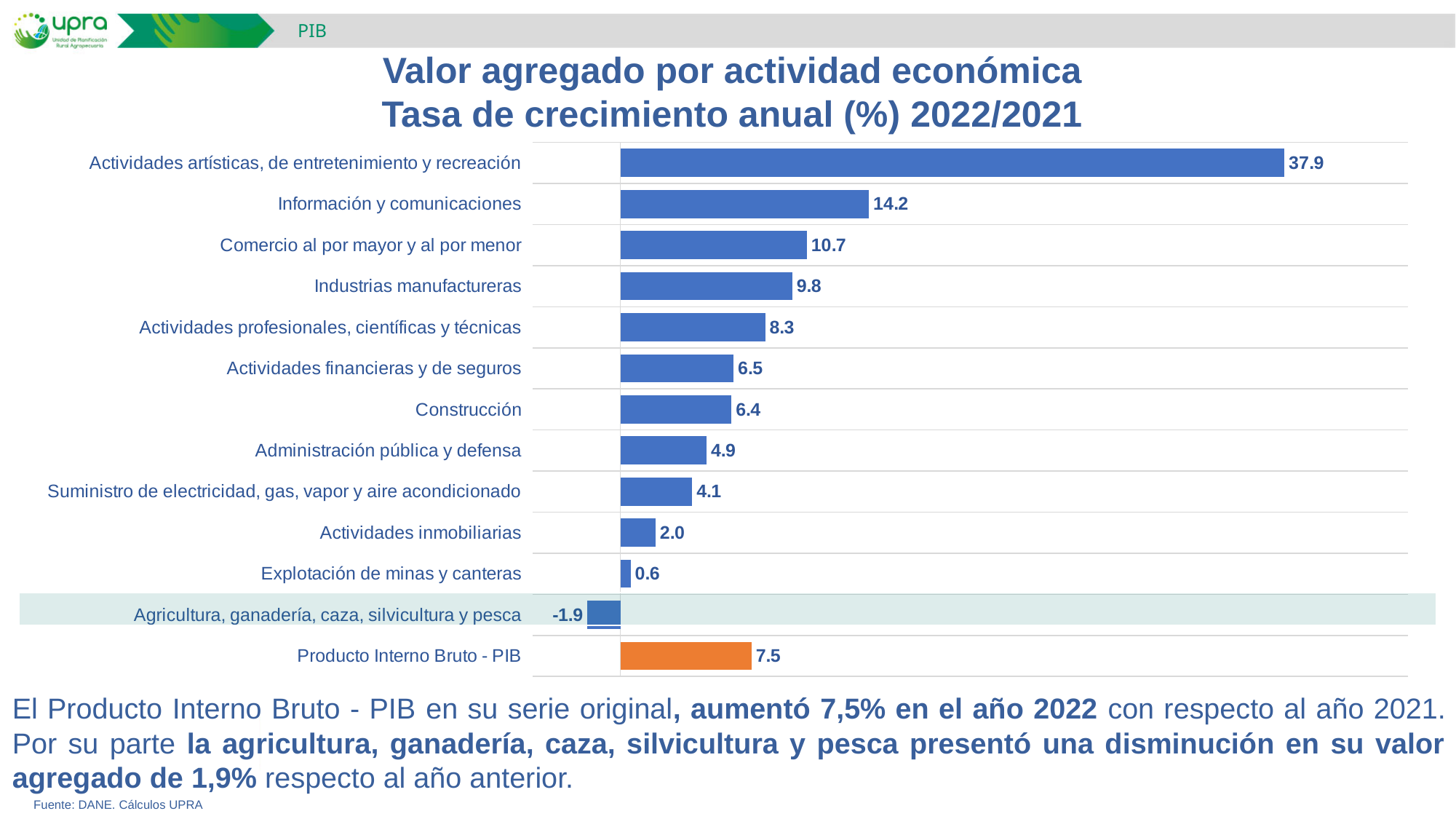
Which bar is shown in orange rather than blue? Producto Interno Bruto - PIB Which category has the lowest value in the chart? Agricultura, ganadería, caza, silvicultura y pesca What is the difference between the value for Actividades artísticas, de entretenimiento y recreación and the PIB value? 30.4 Which activity has the highest growth rate in the chart? Actividades artísticas, de entretenimiento y recreación Which is larger, the value for Construcción or the value for Administración pública y defensa? Construcción What is the annual growth rate shown for Información y comunicaciones? 14.2 What value is shown for Producto Interno Bruto - PIB? 7.5 What type of chart is shown on the slide? Bar chart How many categories (bars) are shown in the chart? 13 What is the growth rate for Agricultura, ganadería, caza, silvicultura y pesca? -1.9 What is the title of the chart? Valor agregado por actividad económica Tasa de crecimiento anual (%) 2022/2021 What is the difference between the values for Comercio al por mayor y al por menor and Industrias manufactureras? 0.9